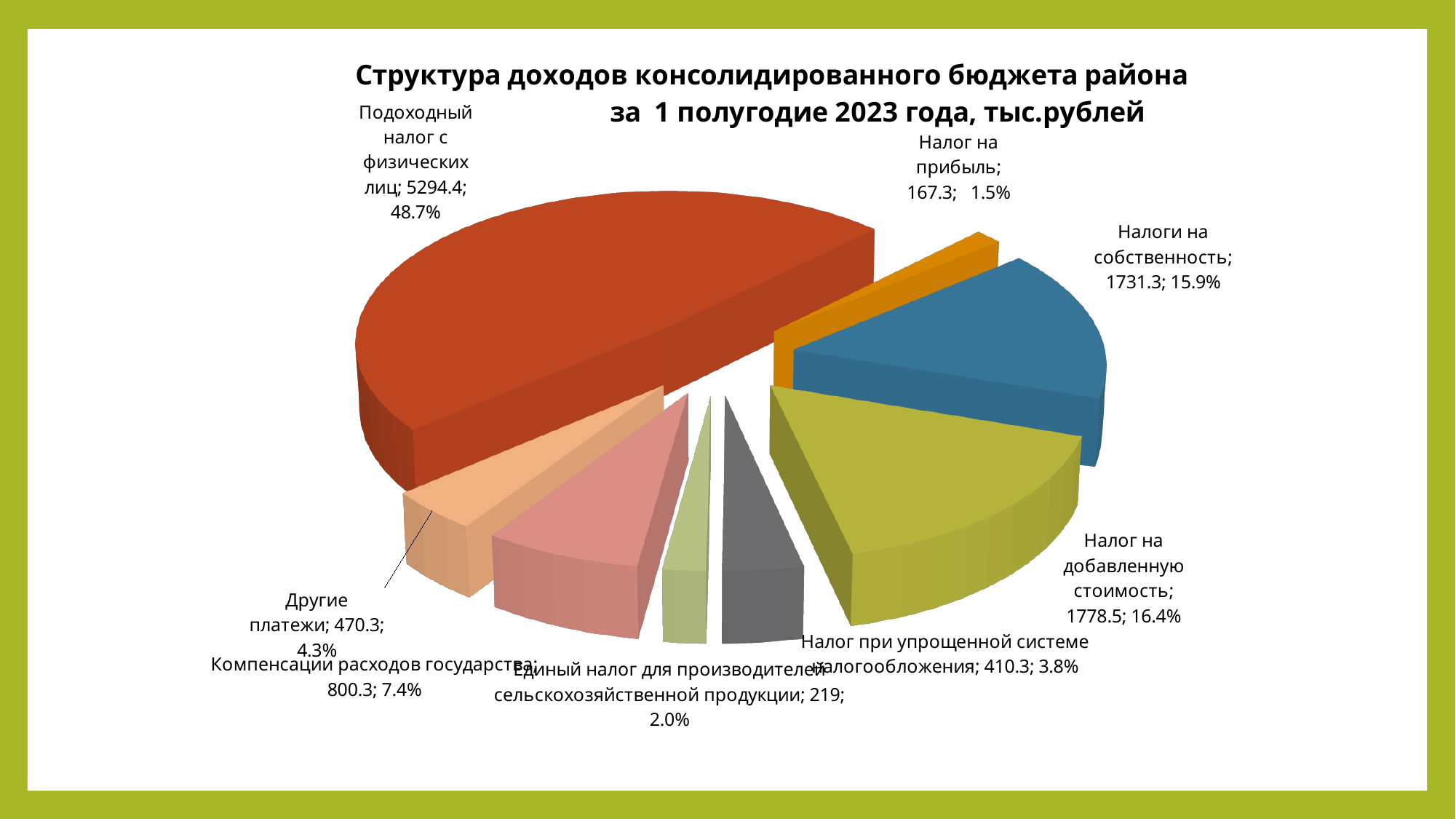
Which is larger: Компенсации расходов государства or Другие платежи? Компенсации расходов государства What is the difference between the values for Налог на добавленную стоимость and Налоги на собственность? 47.2 What is the value for Налог при упрощенной системе налогообложения? 410.3 Which category has the largest slice? Подоходный налог с физических лиц What is the value for Подоходный налог с физических лиц? 5294.4 What is the title of the chart? Структура доходов консолидированного бюджета района за 1 полугодие 2023 года, тыс.рублей What share of the pie does Единый налог для производителей сельскохозяйственной продукции represent? 2.0% What kind of chart is shown on the slide? Pie chart What share of the pie does Налоги на собственность represent? 15.9% What is the value for Налог на добавленную стоимость? 1778.5 How many slices does the pie chart have? 8 Which category has the smallest slice? Налог на прибыль